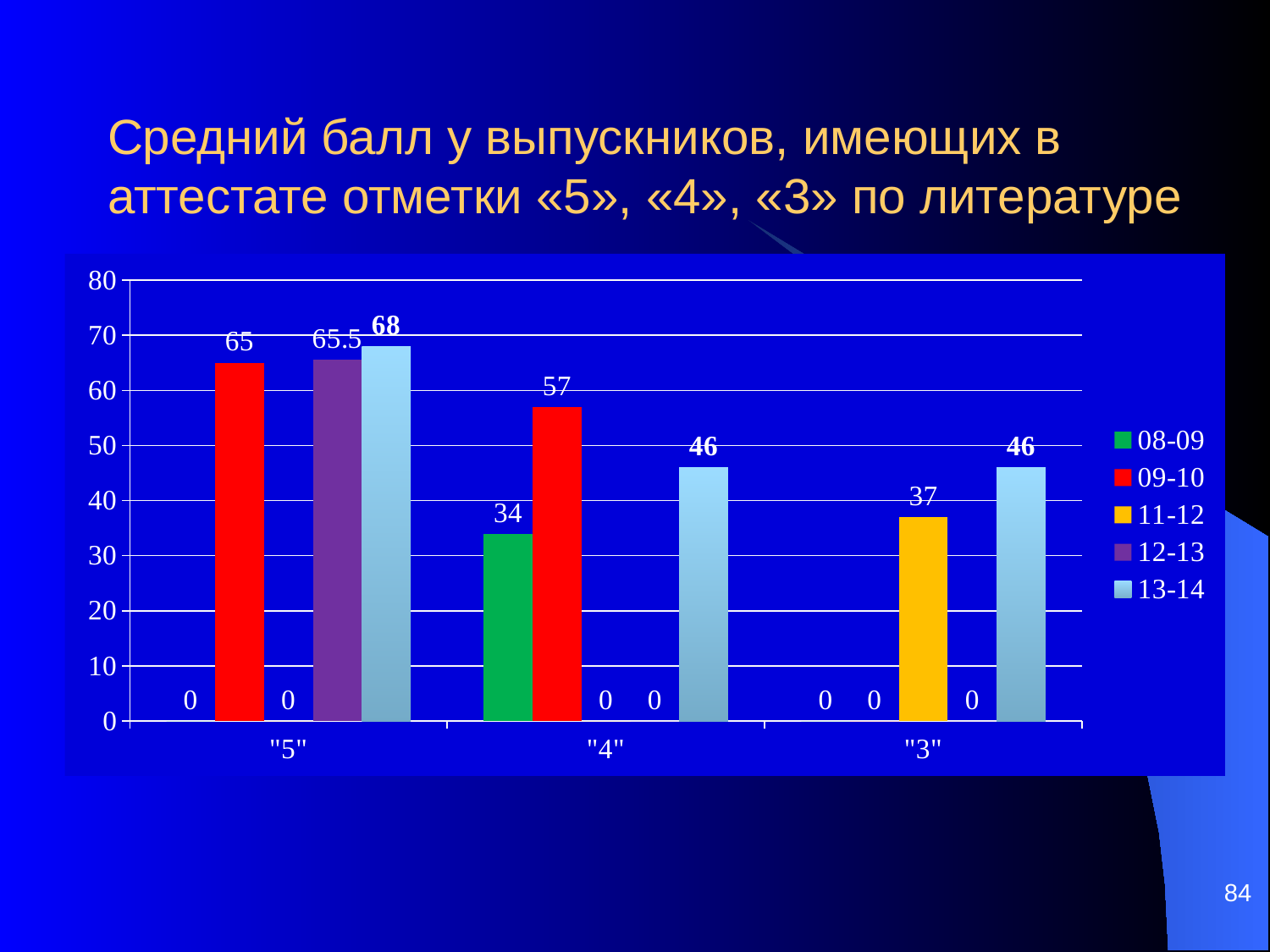
What is the value for the 13-14 series in the "5" category? 68 What colour represents the 11-12 series in the legend? yellow What is the value for the 09-10 series in the "4" category? 57 What kind of chart is shown on the slide? bar chart What is the value for the 08-09 series in the "4" category? 34 What is the difference between the 09-10 and 08-09 values in the "4" category? 23 Which series has the highest value in the "5" category? 13-14 What is the value for the 12-13 series in the "5" category? 65.5 How many categories are shown on the x axis? 3 What is the value for the 11-12 series in the "3" category? 37 How many series does the legend list? 5 Which is larger in the "4" category: the 09-10 value or the 13-14 value? 09-10